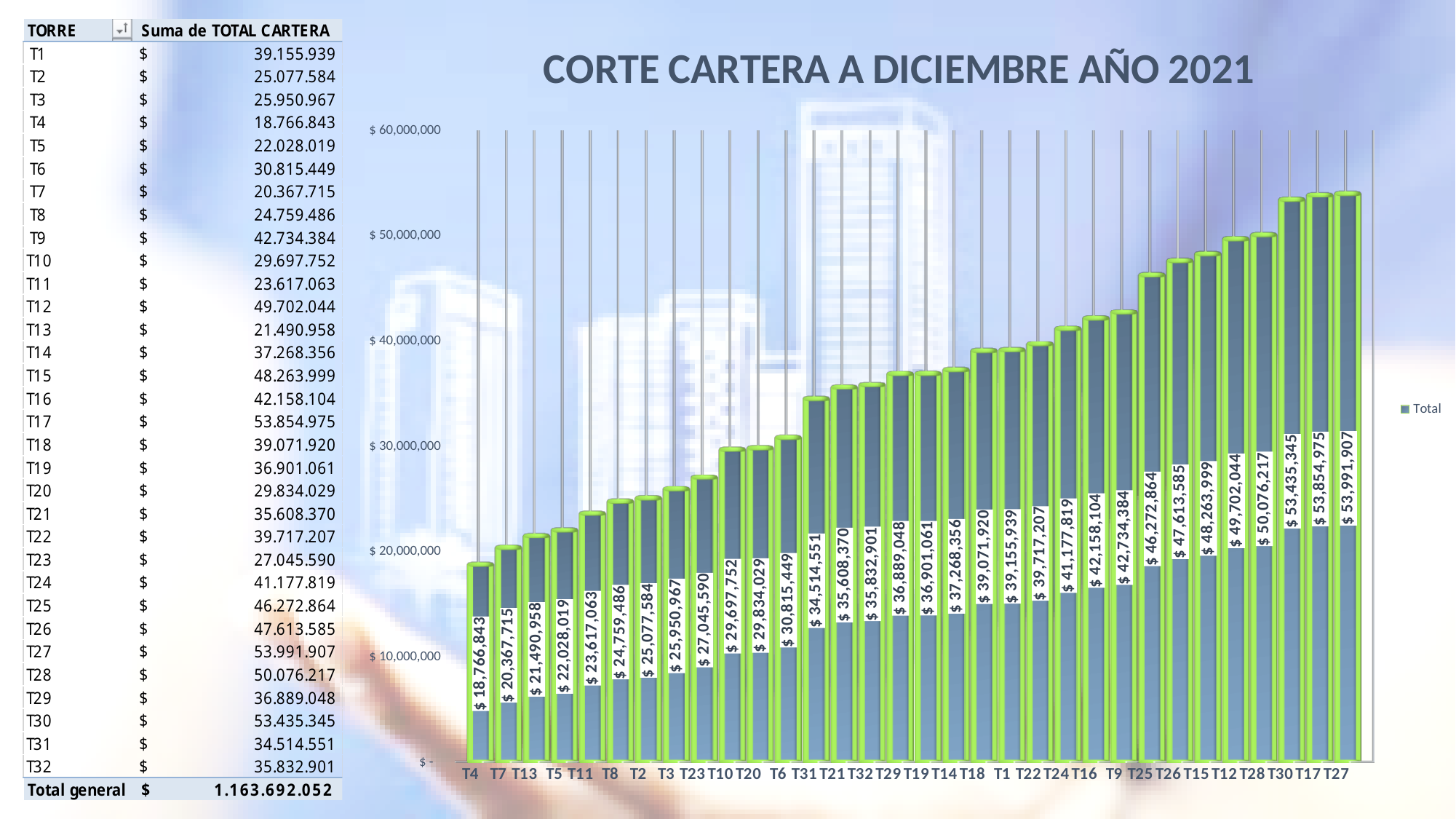
Which tower has the lowest value in the chart? T4 What is the value shown for T25 in the chart? $ 46,272,864 Which tower has the highest value in the chart? T27 What is the title of the chart? CORTE CARTERA A DICIEMBRE AÑO 2021 Do the bar values rise or fall from left to right along the x axis? rise Which has a larger value in the chart, T12 or T15? T12 How many towers (categories) are plotted on the x axis of the chart? 32 Is the value for T23 greater or less than $ 30,000,000? less How many series does the chart legend list? 1 What is the difference between the values for T27 and T4 in the chart? $ 35,225,064 What is the value shown for T31 in the chart? $ 34,514,551 What type of chart is shown on the slide? bar chart